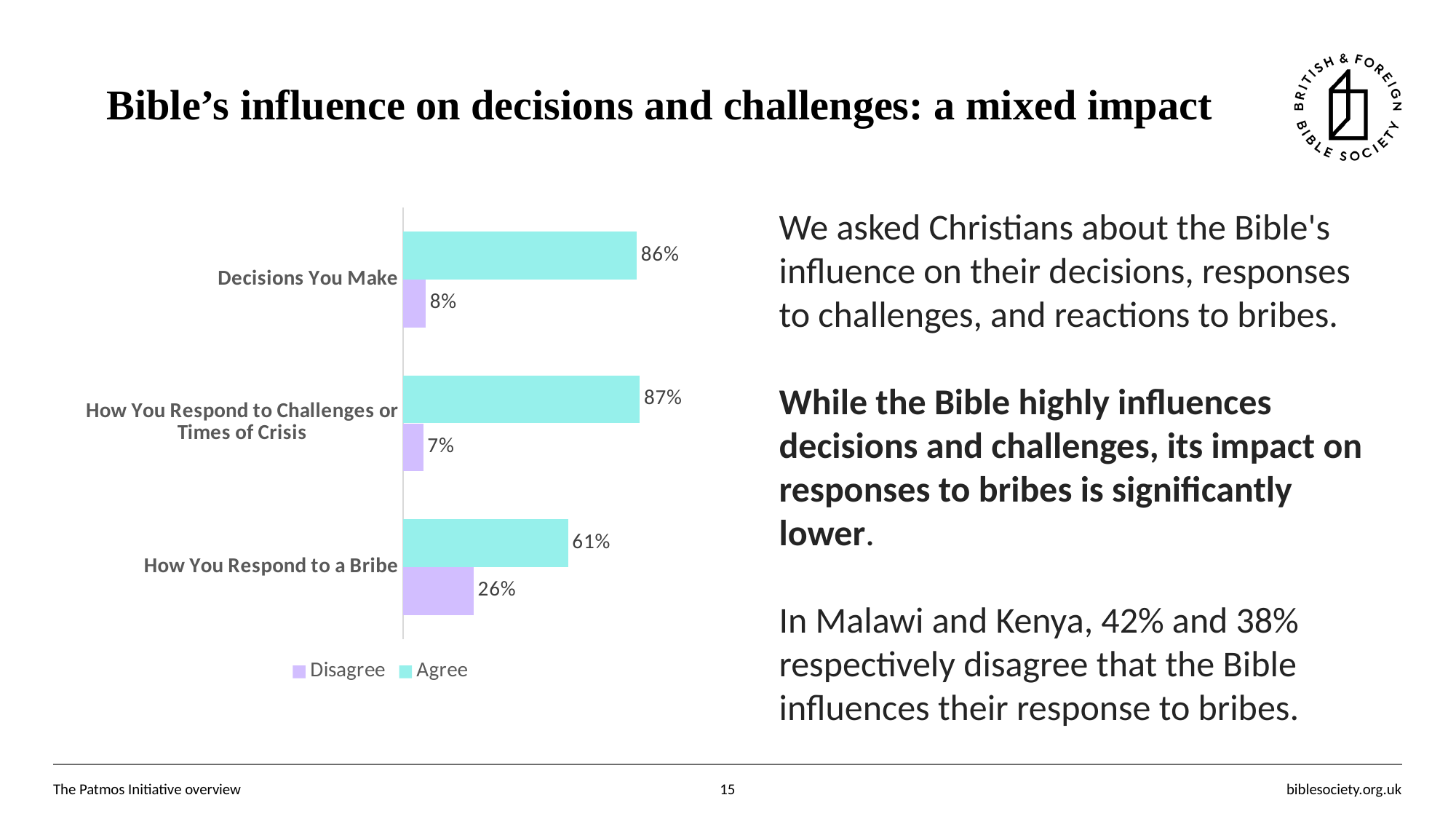
What is the difference between the Agree and Disagree values for 'How You Respond to a Bribe'? 35% What kind of chart is shown on the slide? Bar chart Is the Disagree value larger for 'How You Respond to a Bribe' or for 'Decisions You Make'? How You Respond to a Bribe What percentage agree that the Bible influences the decisions they make? 86% How many series does the legend list? 2 What percentage disagree that the Bible influences how they respond to a bribe? 26% What is the Disagree value for 'Decisions You Make'? 8% Which category has the highest Agree value? How You Respond to Challenges or Times of Crisis Which category has the lowest Agree value? How You Respond to a Bribe How many categories are shown in the chart? 3 Which category has the lowest Disagree value? How You Respond to Challenges or Times of Crisis What is the Agree value for 'How You Respond to Challenges or Times of Crisis'? 87%